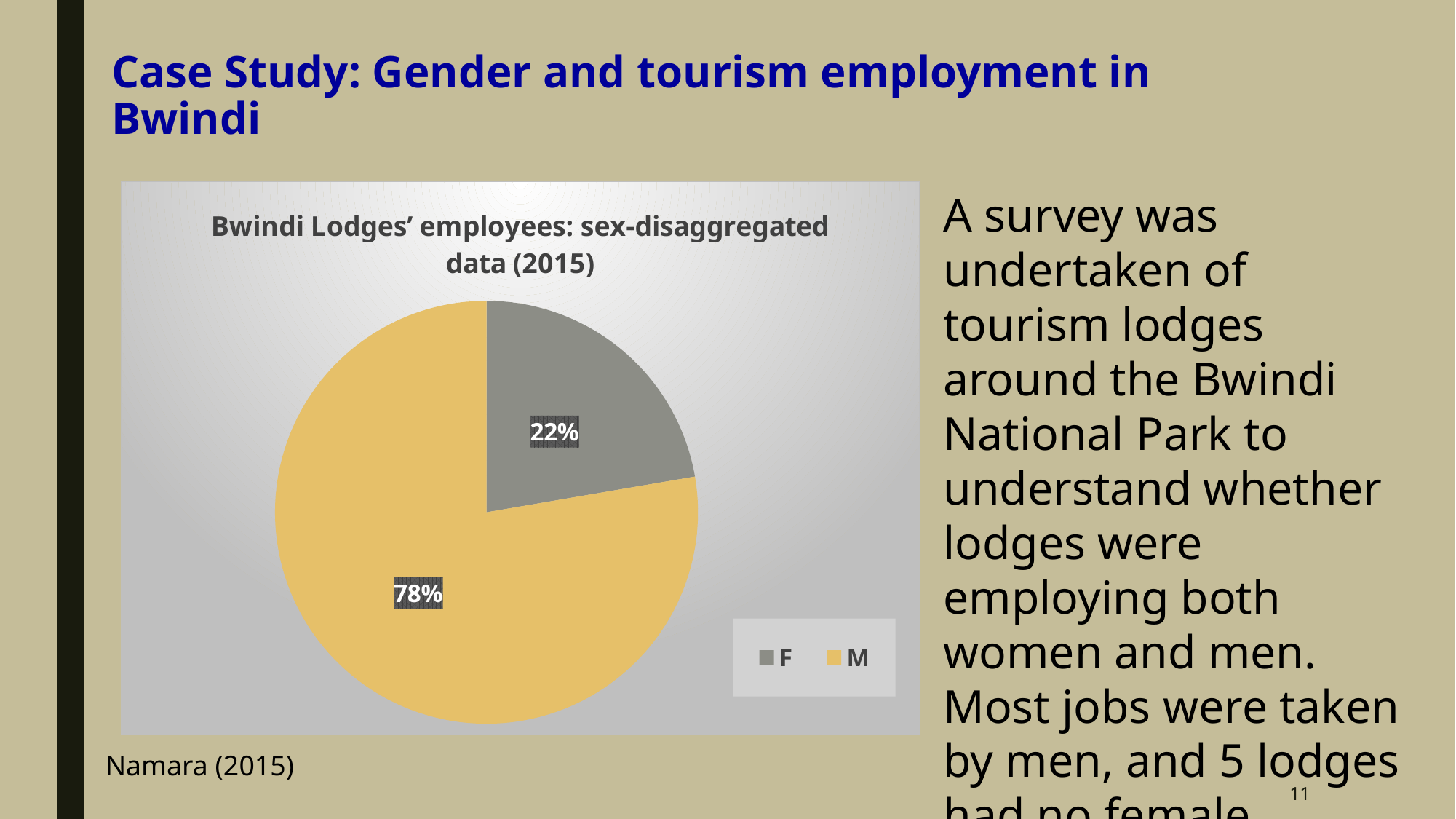
What colour is the M slice in the pie chart? yellow How many slices does the pie chart have? 2 Which category has the smaller slice of the pie chart? F Which category has the larger slice of the pie chart, F or M? M Is the share for M greater or less than 50%? greater What type of chart is shown on the slide? pie chart What is the difference in percentage points between the M and F slices? 56 Is the share for F larger or smaller than the share for M? smaller What share of Bwindi Lodges' employees is male (M) according to the pie chart? 78% How many entries does the chart legend list? 2 What is the title of the chart? Bwindi Lodges' employees: sex-disaggregated data (2015) What share of Bwindi Lodges' employees is female (F) according to the pie chart? 22%